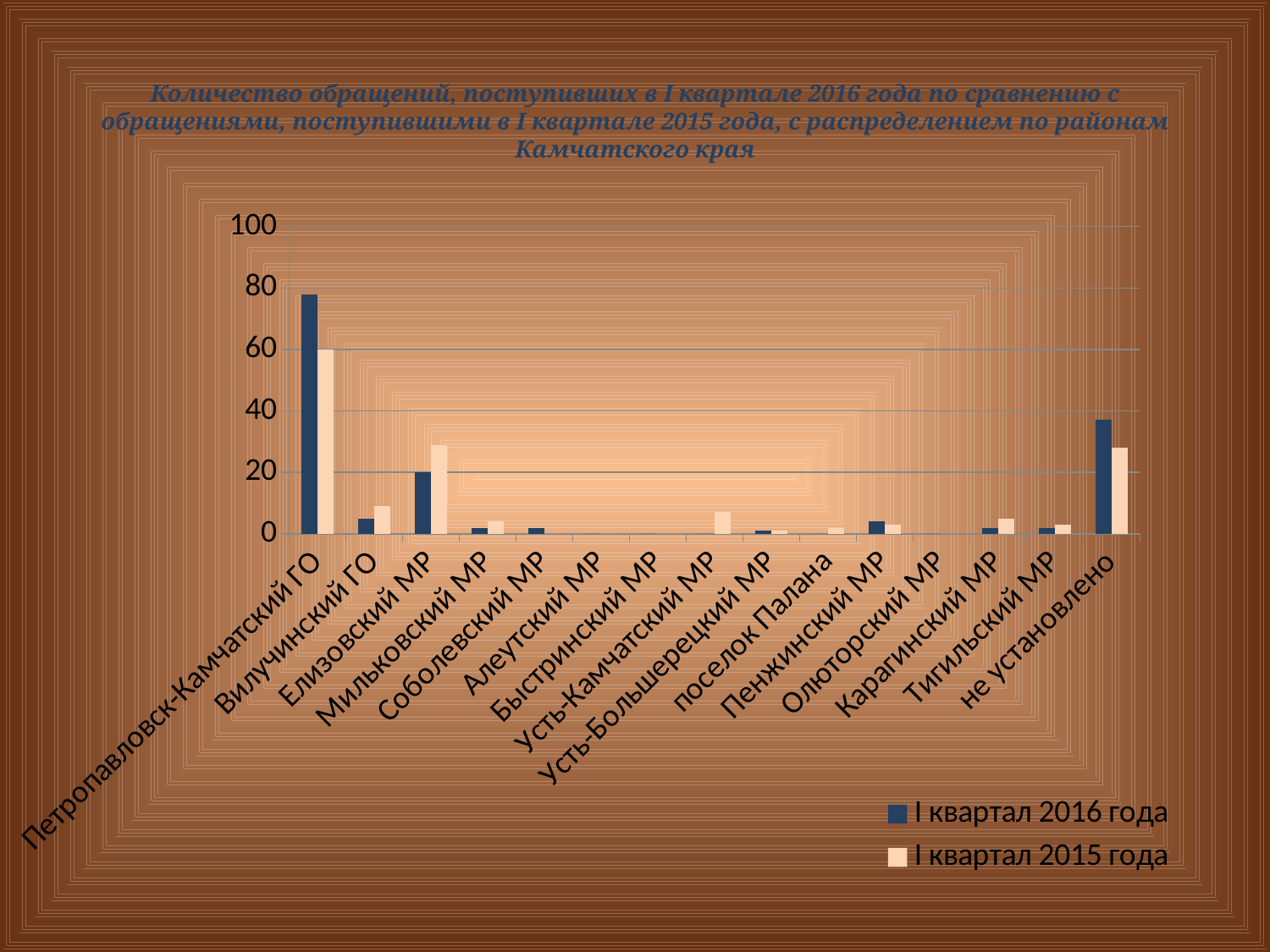
How many categories (districts) are shown along the x axis? 15 For Елизовский МР, which series has the larger value: 'I квартал 2016 года' or 'I квартал 2015 года'? I квартал 2015 года Which has the larger value in 'I квартал 2016 года': Елизовский МР or не установлено? не установлено Is the value for 'не установлено' in 'I квартал 2016 года' greater or less than 20? greater How many series does the legend list? 2 Is the value for Елизовский МР in 'I квартал 2015 года' greater or less than 40? less For Петропавловск-Камчатский ГО, which series has the larger value: 'I квартал 2016 года' or 'I квартал 2015 года'? I квартал 2016 года Is the value for Петропавловск-Камчатский ГО in 'I квартал 2016 года' greater or less than 60? greater What kind of chart is shown on the slide? bar chart Which category has the highest value for the series 'I квартал 2015 года'? Петропавловск-Камчатский ГО What are the two legend entries of the chart? I квартал 2016 года; I квартал 2015 года Which category has the highest value for the series 'I квартал 2016 года'? Петропавловск-Камчатский ГО